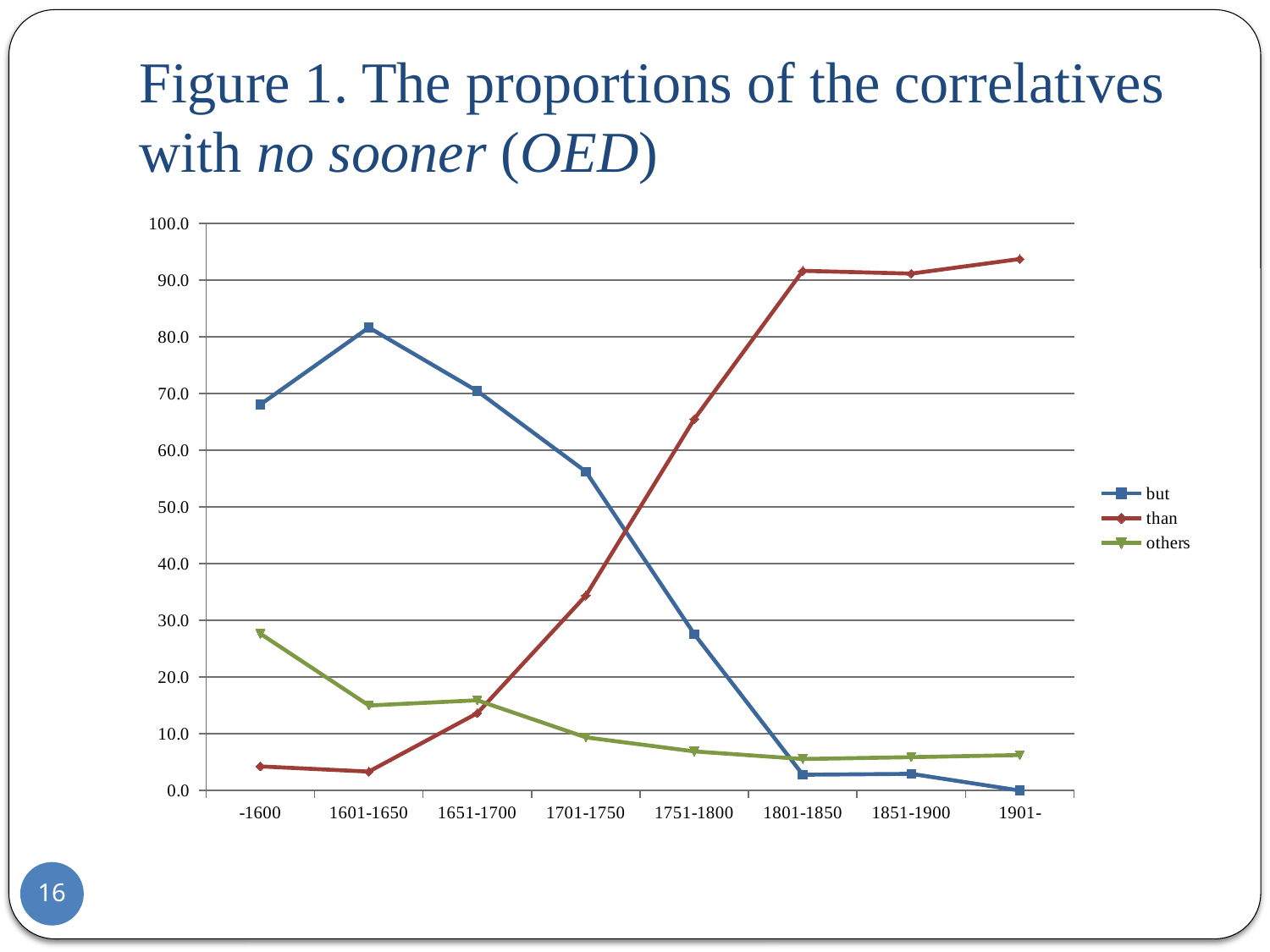
Is the value for 'than' in 1801-1850 greater or less than 80? greater How many time periods are shown on the x axis? 8 Which series has the lowest value in the 1901- period? but What is the value for 'but' in the 1901- period? 0.0 Is the value for 'others' in the -1600 period greater or less than 20? greater Does the value for 'than' generally rise or fall from -1600 to 1901-? rise Which series has the highest value in the 1701-1750 period? but In the 1751-1800 period, which is larger, the value for 'but' or the value for 'than'? than How many series does the legend list? 3 Is the value for 'than' in the -1600 period greater or less than 10? less What kind of chart is shown on the slide? line chart In which period is the value for 'but' highest? 1601-1650